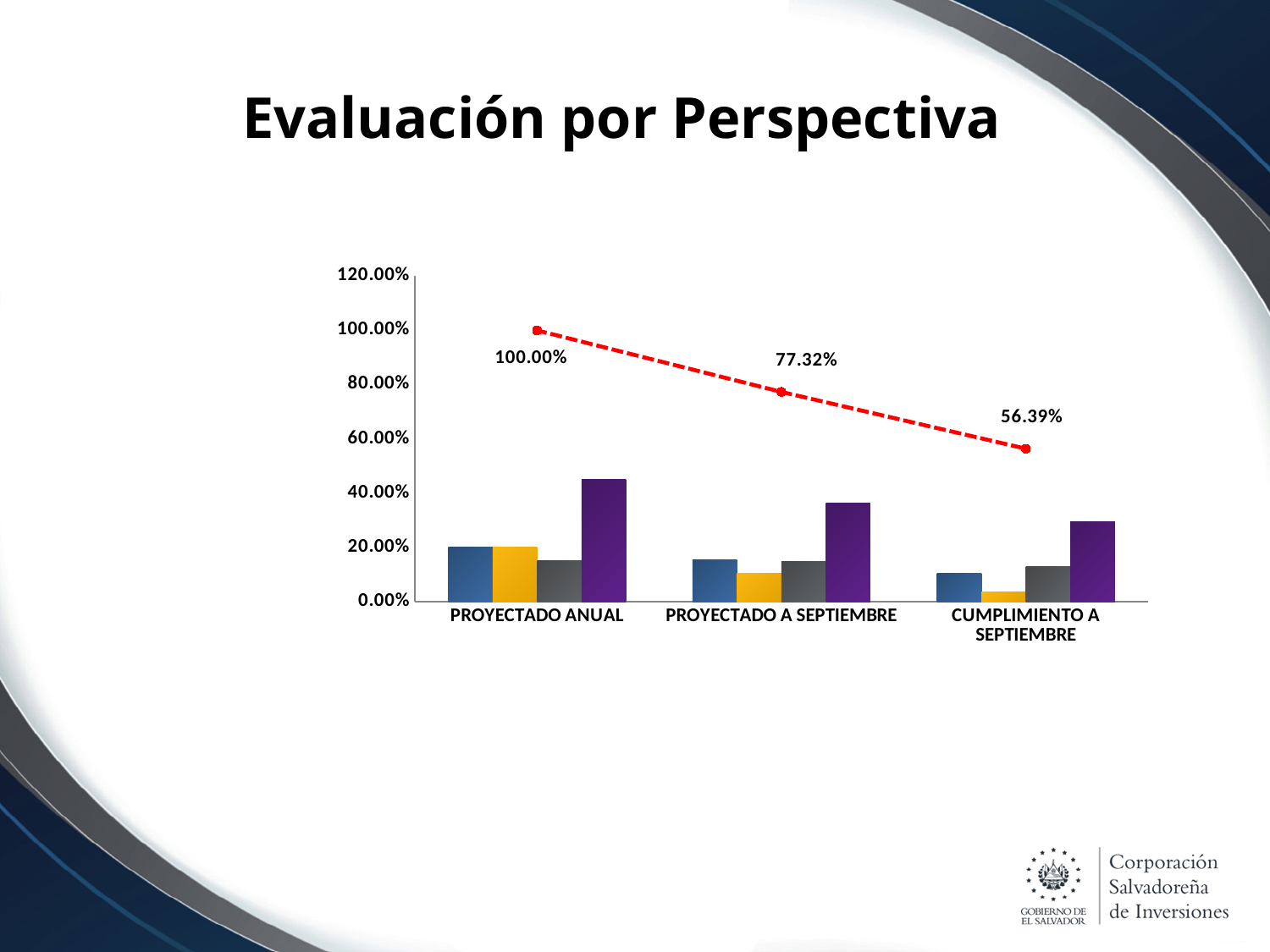
Is the purple bar for CUMPLIMIENTO A SEPTIEMBRE greater or less than 40.00%? less Which category has the lowest value on the dashed red line? CUMPLIMIENTO A SEPTIEMBRE Which purple bar is taller: the one for PROYECTADO ANUAL or the one for CUMPLIMIENTO A SEPTIEMBRE? PROYECTADO ANUAL What value does the dashed red line show for CUMPLIMIENTO A SEPTIEMBRE? 56.39% What is the title of the slide containing the chart? Evaluación por Perspectiva What value does the dashed red line show for PROYECTADO ANUAL? 100.00% What is the difference between the line values for PROYECTADO A SEPTIEMBRE and CUMPLIMIENTO A SEPTIEMBRE? 20.93% Which category has the highest value on the dashed red line? PROYECTADO ANUAL What value does the dashed red line show for PROYECTADO A SEPTIEMBRE? 77.32% What is the difference between the line values for PROYECTADO ANUAL and CUMPLIMIENTO A SEPTIEMBRE? 43.61% How many categories are shown on the x axis? 3 Do the values on the dashed red line rise or fall from left to right across the categories? fall